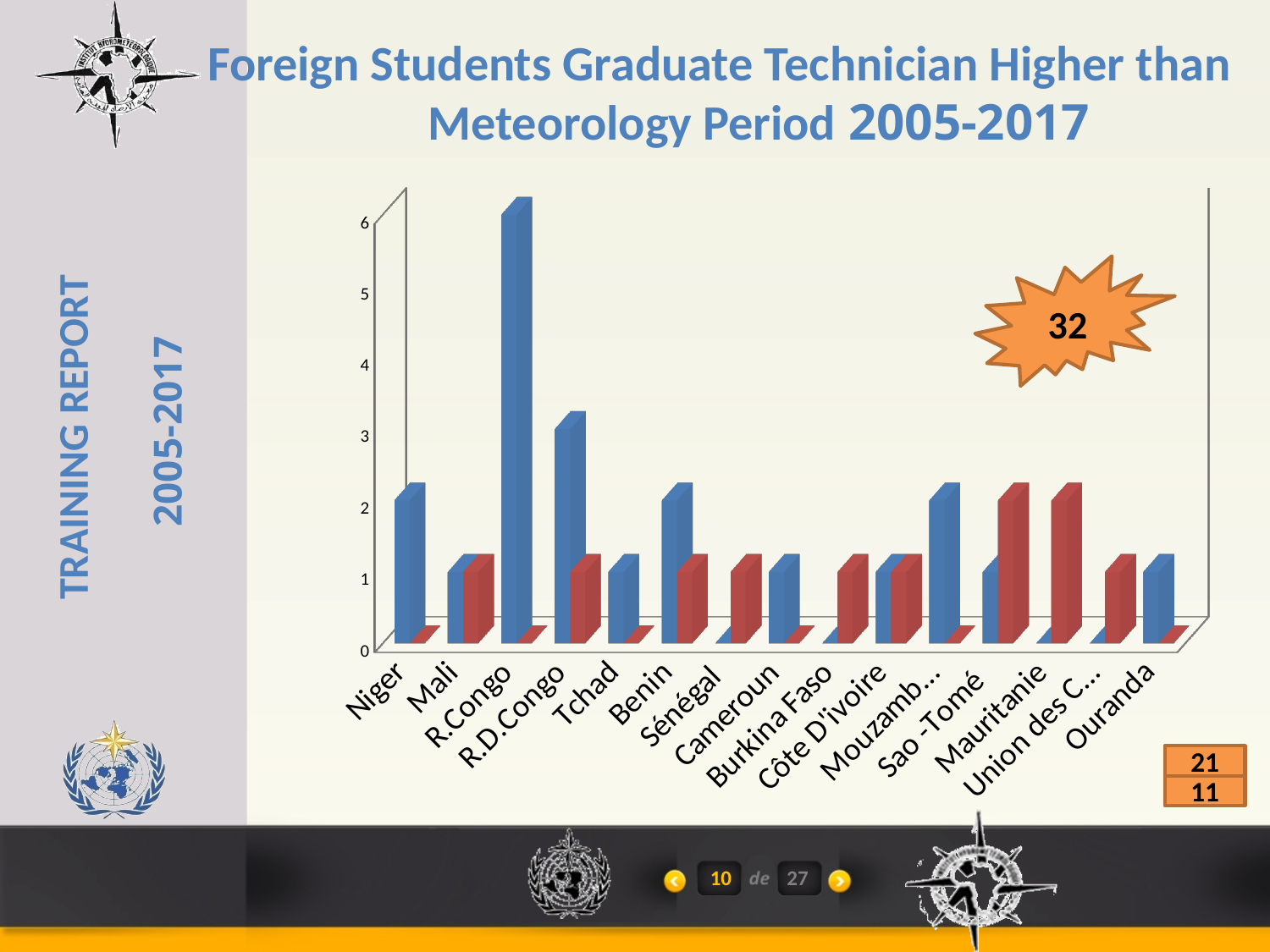
What number is shown in the orange starburst on the chart? 32 Is the blue bar for Benin greater or less than 3? less What is the value of the red bar for Mauritanie? 2 What is the value of the blue bar for R.D.Congo? 3 What is the value of the blue bar for R.Congo? 6 Which is larger, the blue bar for R.D.Congo or the blue bar for Tchad? R.D.Congo Is the blue bar for R.Congo greater or less than 5? greater Which country has the tallest blue bar in the chart? R.Congo What kind of chart is shown on the slide? bar chart What is the value of the blue bar for Niger? 2 How many countries are listed along the x axis of the chart? 15 What is the difference between the blue bar for R.Congo and the blue bar for R.D.Congo? 3